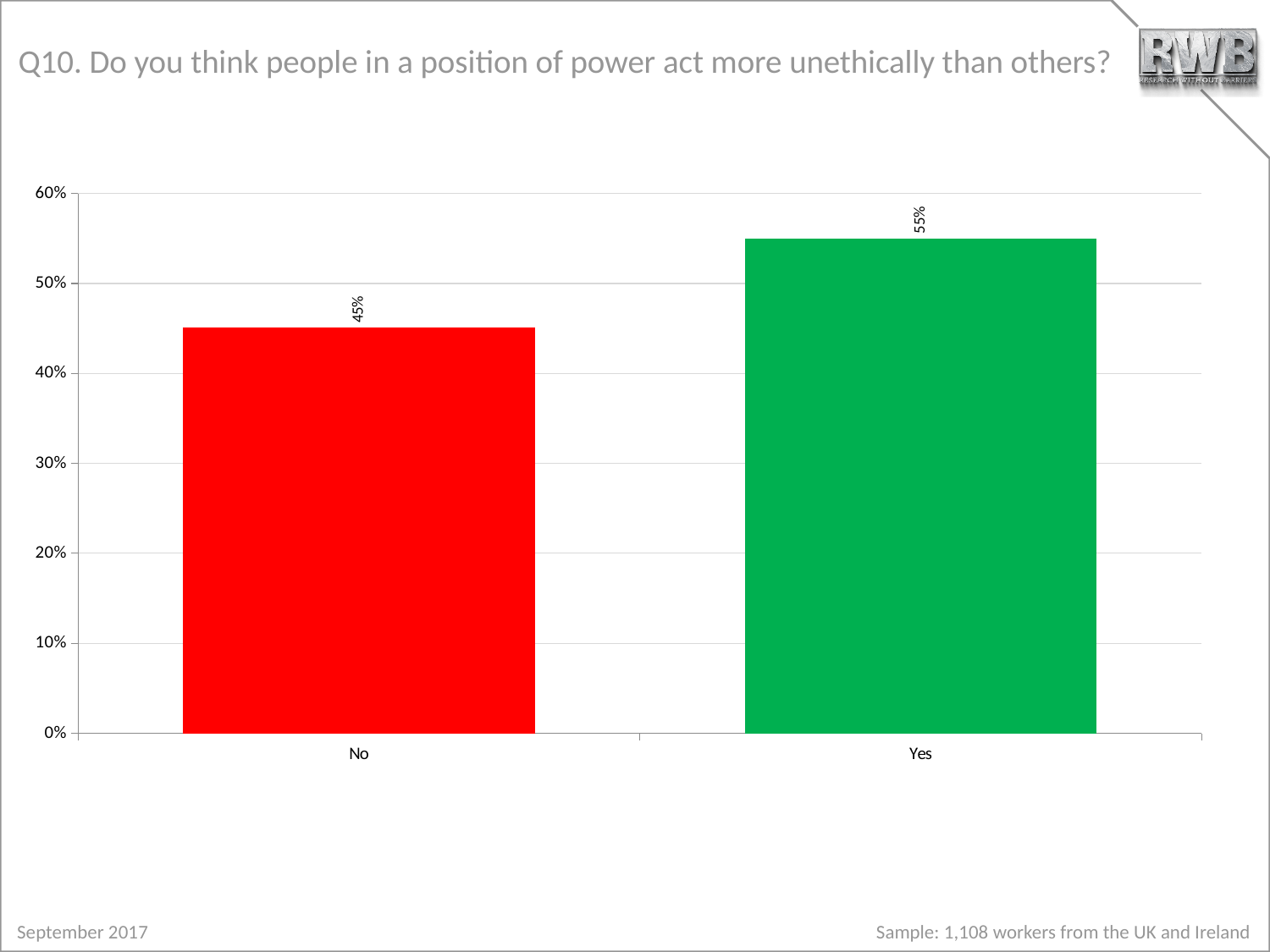
What colour is the bar for the "Yes" response? Green What kind of chart is shown on the slide? Bar chart Is the value for "Yes" greater or less than 50%? greater Which response has the lowest value? No What is the maximum value shown on the vertical axis? 60% Is the value for "No" greater or less than 50%? less What percentage of respondents answered "No"? 45% What percentage of respondents answered "Yes"? 55% Which response has the highest value? Yes What is the difference in percentage points between the "Yes" and "No" responses? 10 percentage points Which is larger, the value for "Yes" or the value for "No"? Yes How many response categories are shown on the chart? 2